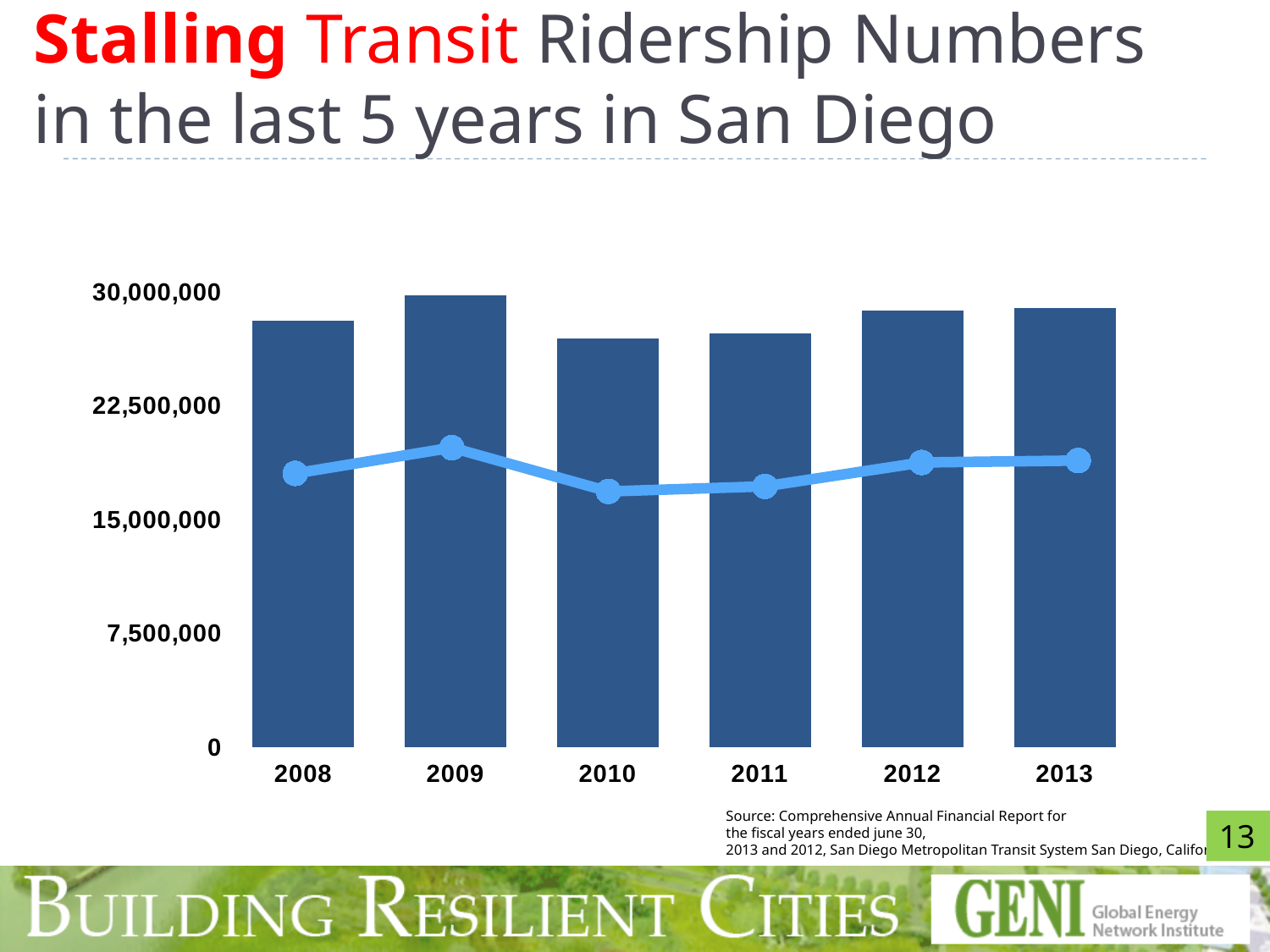
Is the bar value for 2010 greater or less than 22,500,000? greater What is the highest value labelled on the y axis? 30,000,000 Which bar is taller, 2009 or 2010? 2009 Which year has the tallest bar in the chart? 2009 How many years are shown on the x axis of the chart? 6 Which line point is higher, 2009 or 2010? 2009 What is the first year shown on the x axis? 2008 What kind of chart is shown on the slide? A bar chart with a line overlaid Is the bar value for 2009 greater or less than 22,500,000? greater Is the line value for 2010 greater or less than 15,000,000? greater Which year has the highest point on the line series? 2009